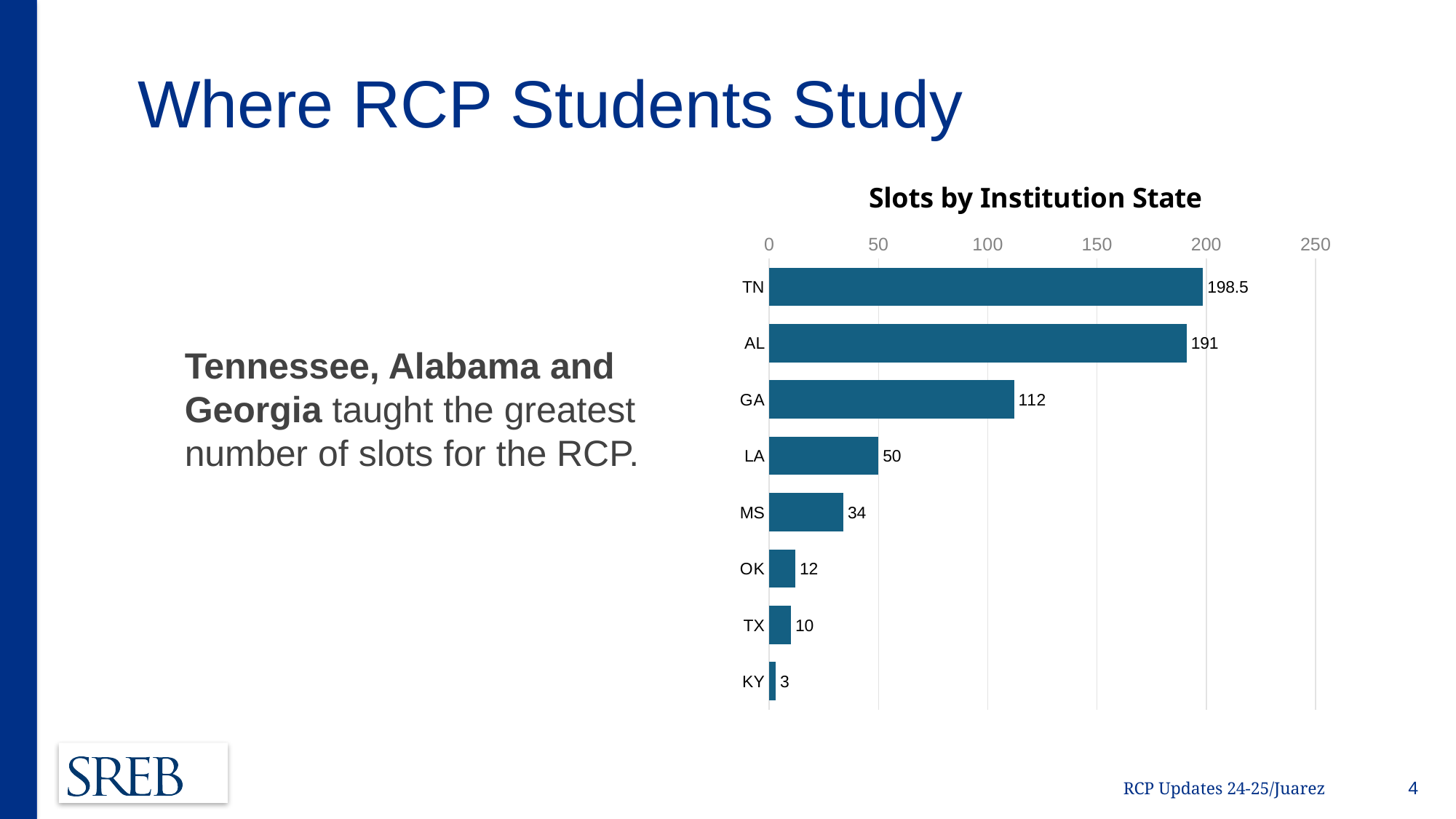
How many states are shown in the chart? 8 What is the value for TN in the Slots by Institution State chart? 198.5 What is the value for MS in the chart? 34 What kind of chart is shown on the slide? Bar chart What is the difference between the values for LA and MS? 16 What is the title of the chart? Slots by Institution State Is the value for GA greater or less than 100? greater Which has a larger value, OK or TX? OK How many slots does GA have in the Slots by Institution State chart? 112 Which state has the lowest number of slots? KY Which state has the highest number of slots? TN What is the difference between the values for AL and GA? 79